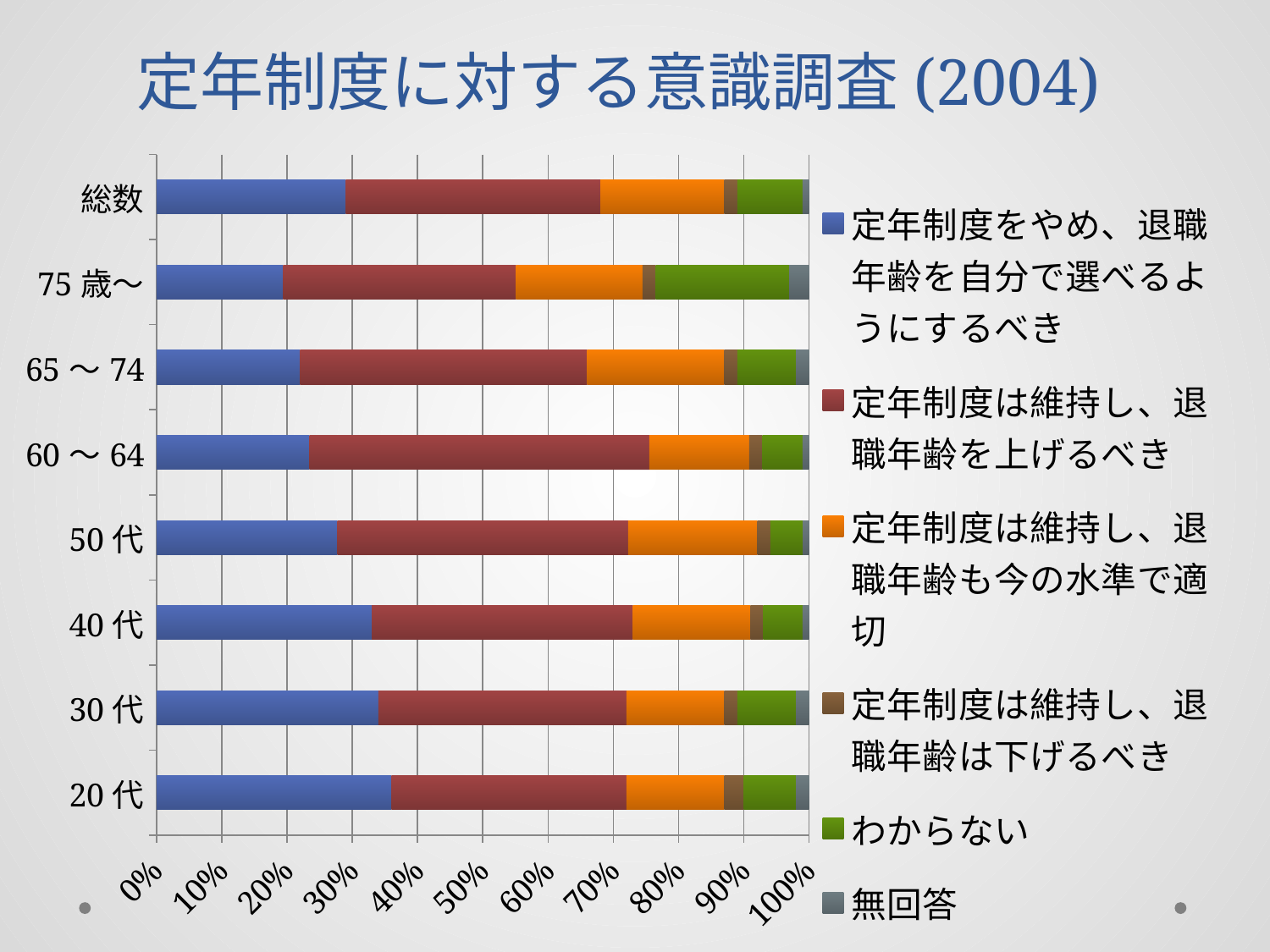
Which has a larger share of 「定年制度をやめ、退職年齢を自分で選べるようにするべき」, 20代 or 75歳～? 20代 What is the title of the chart? 定年制度に対する意識調査 (2004) Is the share of 「定年制度をやめ、退職年齢を自分で選べるようにするべき」 for 60～64 greater or less than 30%? less Which legend entry is shown in green? わからない Is the share of 「定年制度をやめ、退職年齢を自分で選べるようにするべき」 for 40代 greater or less than 30%? greater What kind of chart is shown on the slide? Stacked bar chart How many age-group categories are plotted on the chart? 8 Which age group has the smallest share of 「定年制度をやめ、退職年齢を自分で選べるようにするべき」? 75歳～ Is the share of 「定年制度をやめ、退職年齢を自分で選べるようにするべき」 for 20代 greater or less than 30%? greater Which age group has the largest share of 「わからない」? 75歳～ How many series does the legend list? 6